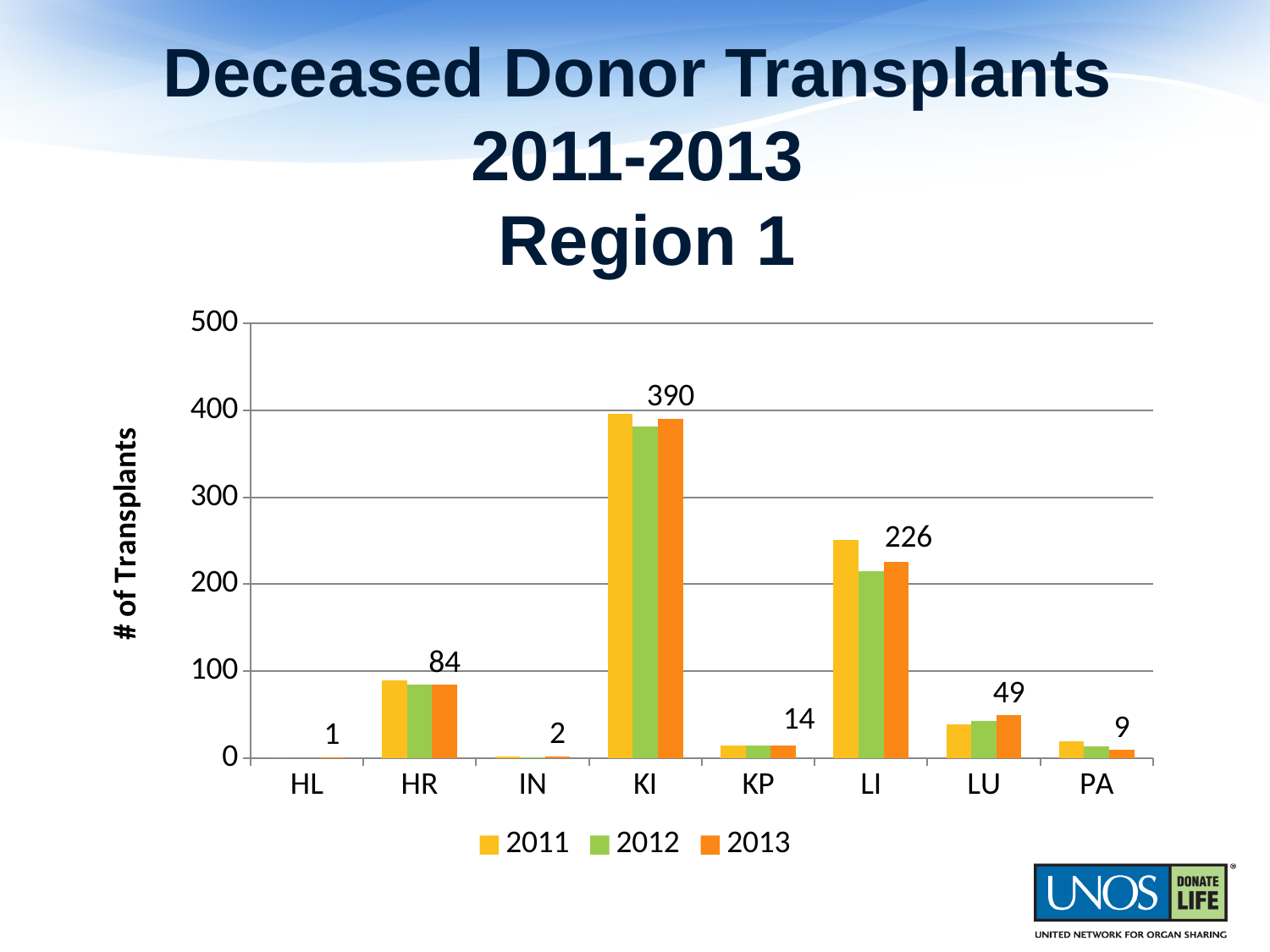
What is the value for KI in 2013? 390 How many series does the legend list? 3 Which organ category has the lowest number of transplants in 2013? HL Is the value for LI in 2011 greater or less than 200? greater How many organ categories are shown on the x axis? 8 Which is larger in 2013, the value for KP or the value for PA? KP What is the value for LU in 2013? 49 What is the value for LI in 2013? 226 What is the difference between the 2013 values for KI and LI? 164 Which organ category has the highest number of transplants in 2013? KI What is the value for HR in 2013? 84 What kind of chart is shown on the slide? Bar chart